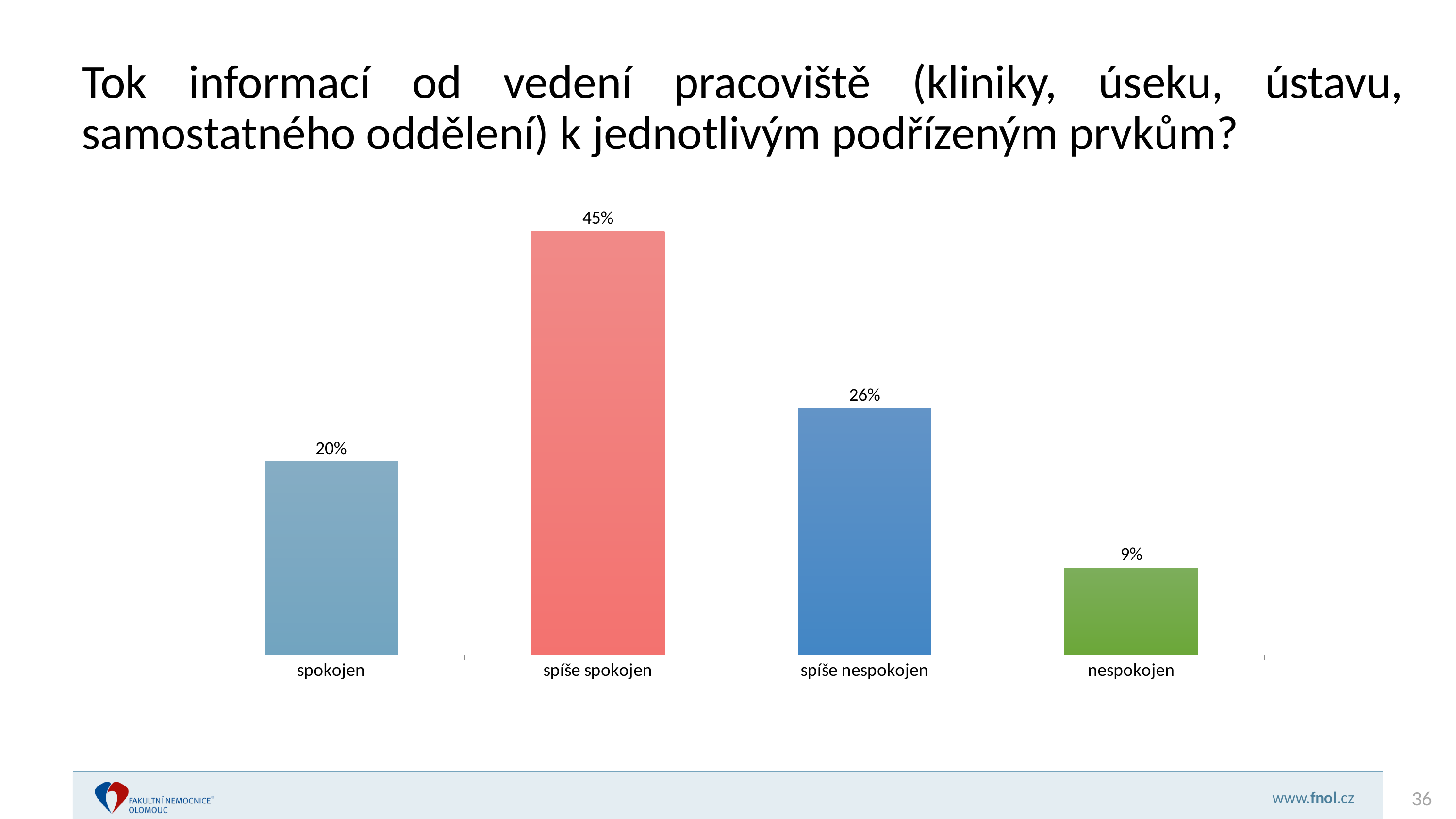
What is the value for "spíše spokojen"? 45% Which category has the highest value? spíše spokojen Which is larger, the value for "spokojen" or the value for "spíše nespokojen"? spíše nespokojen What colour is the bar for "spíše spokojen"? red What kind of chart is shown on the slide? bar chart Which category has the lowest value? nespokojen What is the value for "nespokojen"? 9% What is the value for "spíše nespokojen"? 26% What is the value for "spokojen"? 20% What is the difference between the values for "spíše spokojen" and "spíše nespokojen"? 19% How many categories are shown on the x axis? 4 What is the difference between the values for "spokojen" and "nespokojen"? 11%